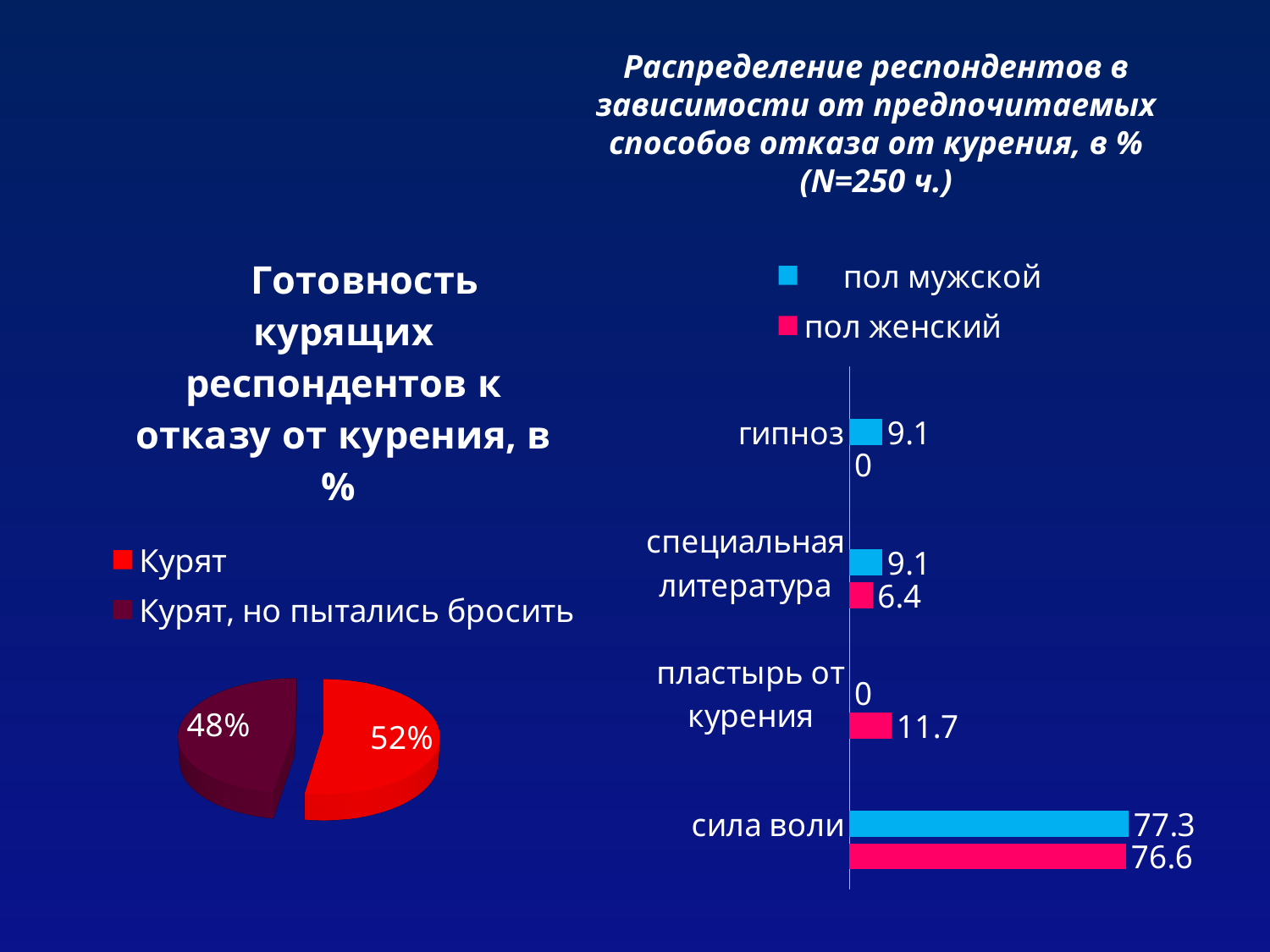
In the bar chart 'Распределение респондентов в зависимости от предпочитаемых способов отказа от курения', what is the value for 'сила воли' in the 'пол мужской' series? 77.3 What kind of chart is the chart on the right of the slide? Bar chart In the bar chart on the right, which category has the highest value in the 'пол мужской' series? сила воли In the pie chart on the left, which slice is larger: 'Курят' or 'Курят, но пытались бросить'? Курят In the pie chart 'Готовность курящих респондентов к отказу от курения, в %', what is the value for 'Курят'? 52% How many categories are shown in the bar chart on the right? 4 What kind of chart is the chart on the left of the slide? Pie chart In the bar chart on the right, what is the difference between the 'пол мужской' and 'пол женский' values for 'сила воли'? 0.7 In the pie chart 'Готовность курящих респондентов к отказу от курения, в %', what is the value for 'Курят, но пытались бросить'? 48% In the bar chart 'Распределение респондентов в зависимости от предпочитаемых способов отказа от курения', what is the value for 'пластырь от курения' in the 'пол женский' series? 11.7 In the bar chart on the right, what is the value for 'специальная литература' in the 'пол женский' series? 6.4 How many series does the legend of the bar chart on the right list? 2